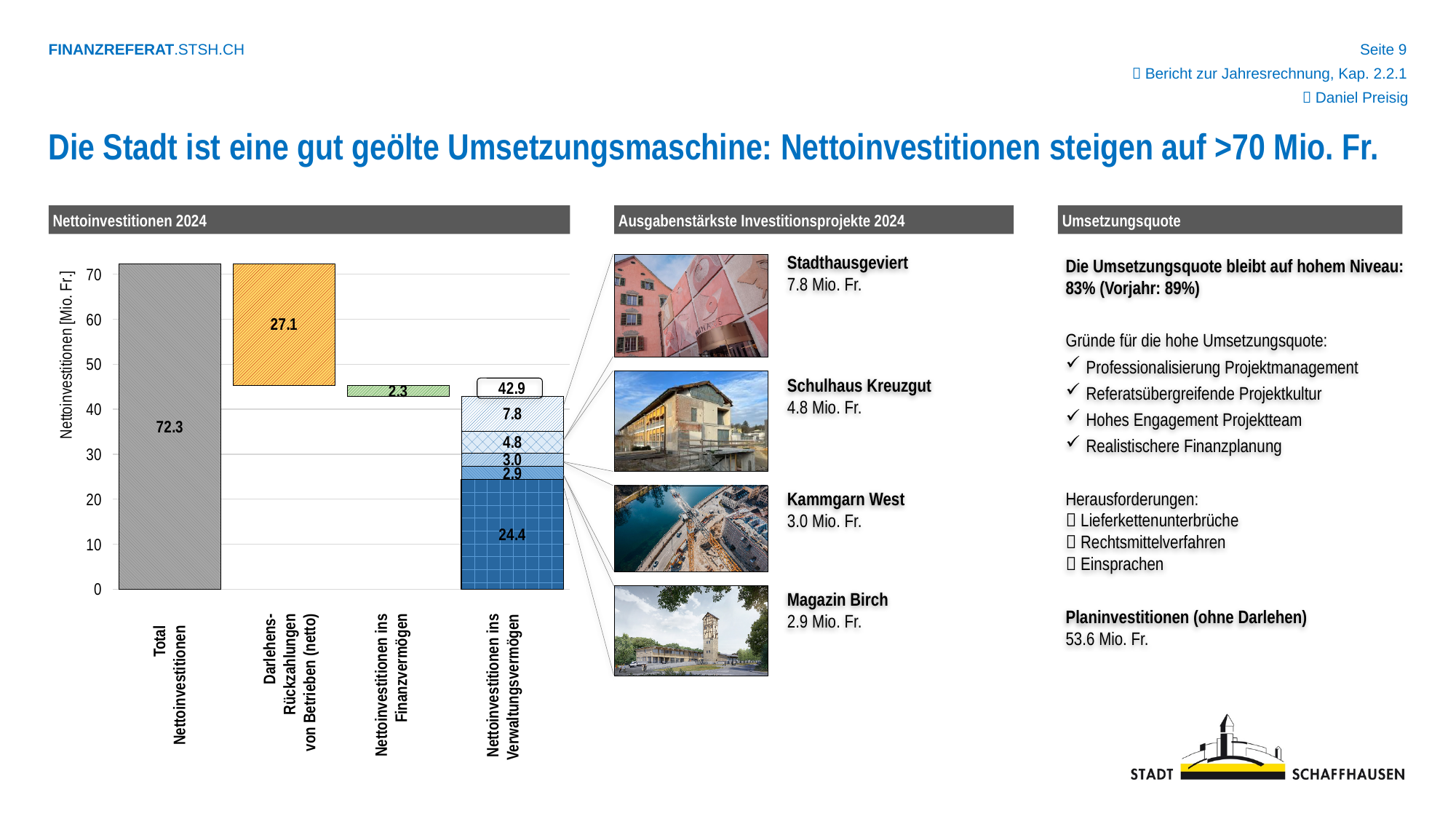
In the Nettoinvestitionen 2024 chart, what is the value of the largest segment in the Nettoinvestitionen ins Verwaltungsvermögen bar? 24.4 In the Nettoinvestitionen 2024 chart, what is the total value shown for Nettoinvestitionen ins Verwaltungsvermögen? 42.9 In the Nettoinvestitionen 2024 chart, which is larger: Darlehens-Rückzahlungen von Betrieben (netto) or Nettoinvestitionen ins Verwaltungsvermögen? Nettoinvestitionen ins Verwaltungsvermögen How many categories are shown on the x axis of the Nettoinvestitionen 2024 chart? 4 In the Nettoinvestitionen 2024 chart, what is the value for Total Nettoinvestitionen? 72.3 In the Nettoinvestitionen 2024 chart, what is the value for Nettoinvestitionen ins Finanzvermögen? 2.3 In the Nettoinvestitionen 2024 chart, what is the difference between Total Nettoinvestitionen and Nettoinvestitionen ins Verwaltungsvermögen? 29.4 In the Nettoinvestitionen 2024 chart, what is the value for Darlehens-Rückzahlungen von Betrieben (netto)? 27.1 What kind of chart is the Nettoinvestitionen 2024 chart? Bar chart In the Nettoinvestitionen 2024 chart, which category has the highest value? Total Nettoinvestitionen What is the y-axis label of the Nettoinvestitionen 2024 chart? Nettoinvestitionen [Mio. Fr.] In the Nettoinvestitionen 2024 chart, which category has the lowest value? Nettoinvestitionen ins Finanzvermögen